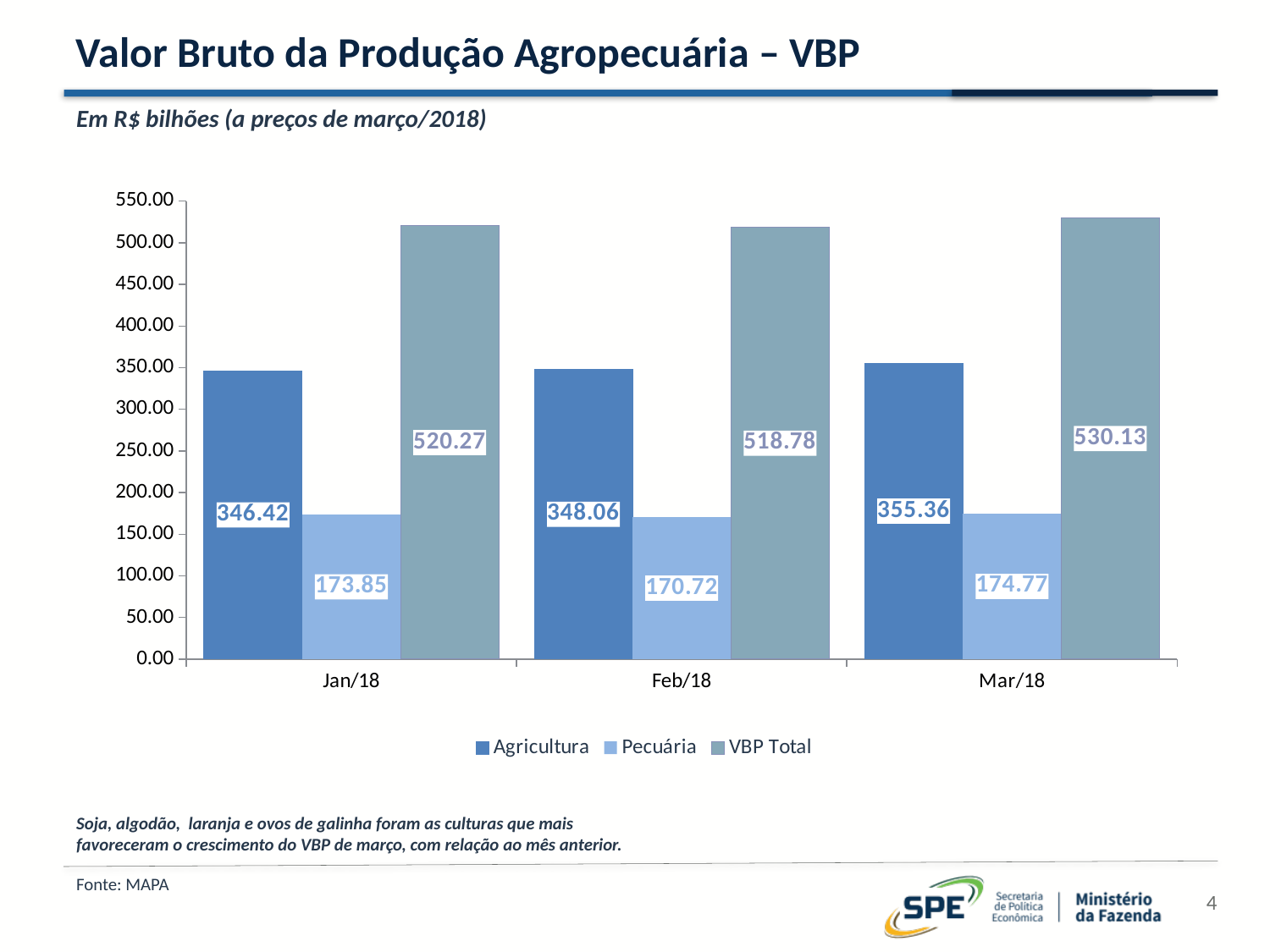
In which month is VBP Total highest? Mar/18 How many series does the legend list? 3 What is the value for Pecuária in Feb/18? 170.72 Does the Agricultura series rise or fall from Jan/18 to Mar/18? rise What is the difference between Agricultura in Mar/18 and in Jan/18? 8.94 What is the value for VBP Total in Mar/18? 530.13 In which month is Pecuária lowest? Feb/18 Is the value for Agricultura in Feb/18 greater or less than 300.00? greater Which is larger: Pecuária in Jan/18 or Pecuária in Mar/18? Mar/18 What is the value for Agricultura in Jan/18? 346.42 What is the difference between VBP Total in Mar/18 and in Feb/18? 11.35 How many months are shown on the x axis? 3